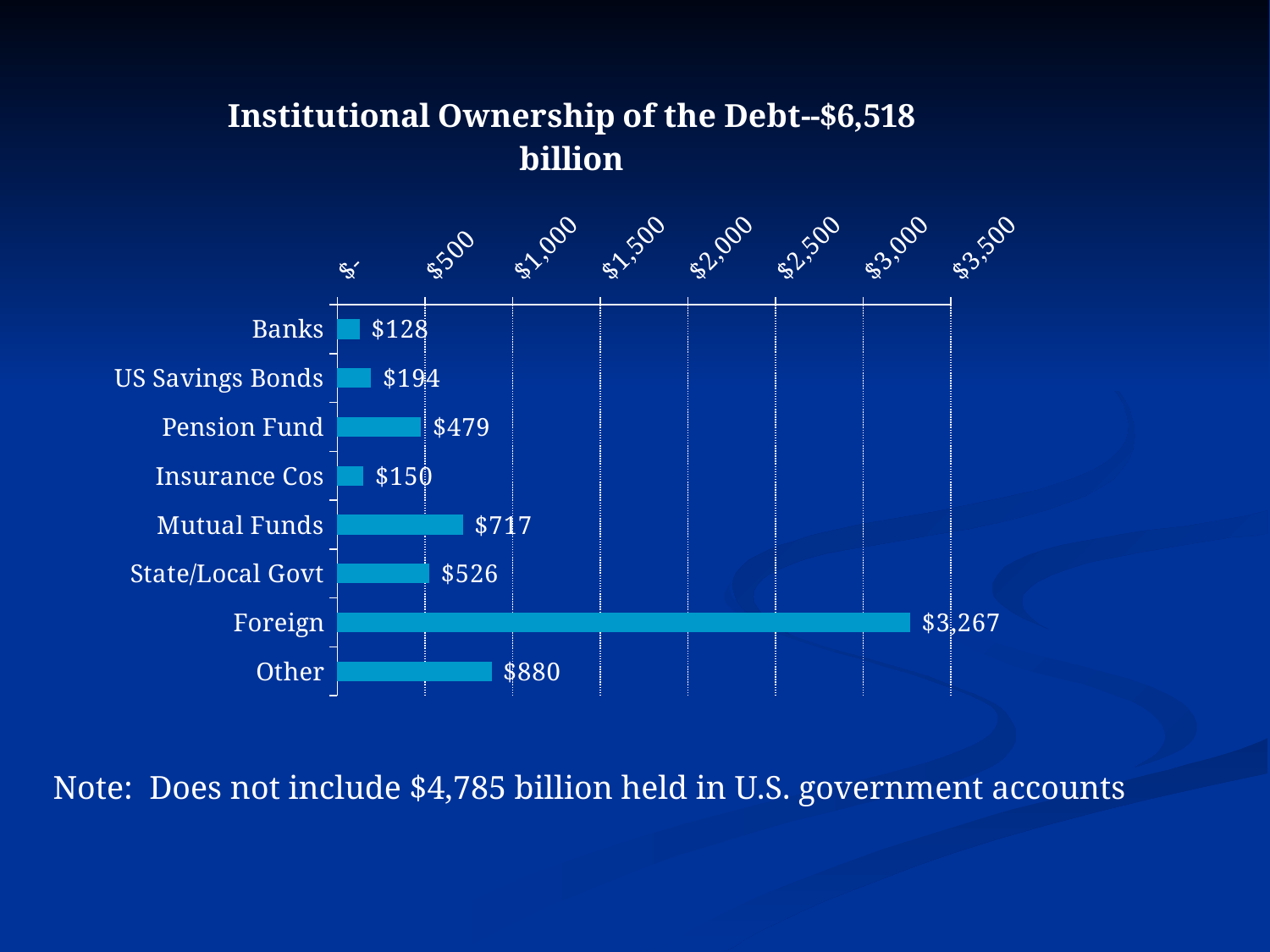
Which is larger, the value for US Savings Bonds or the value for Insurance Cos? US Savings Bonds What is the value for Mutual Funds? $717 Is the value for Mutual Funds greater or less than $500? greater What is the difference between the values for Other and State/Local Govt? $354 Which category has the lowest value? Banks What is the value for Pension Fund? $479 How many categories are shown in the chart? 8 What is the difference between the values for Foreign and Other? $2,387 What kind of chart is shown on the slide? Bar chart Which category has the highest value? Foreign What is the title of the chart? Institutional Ownership of the Debt--$6,518 billion What is the value for Foreign? $3,267